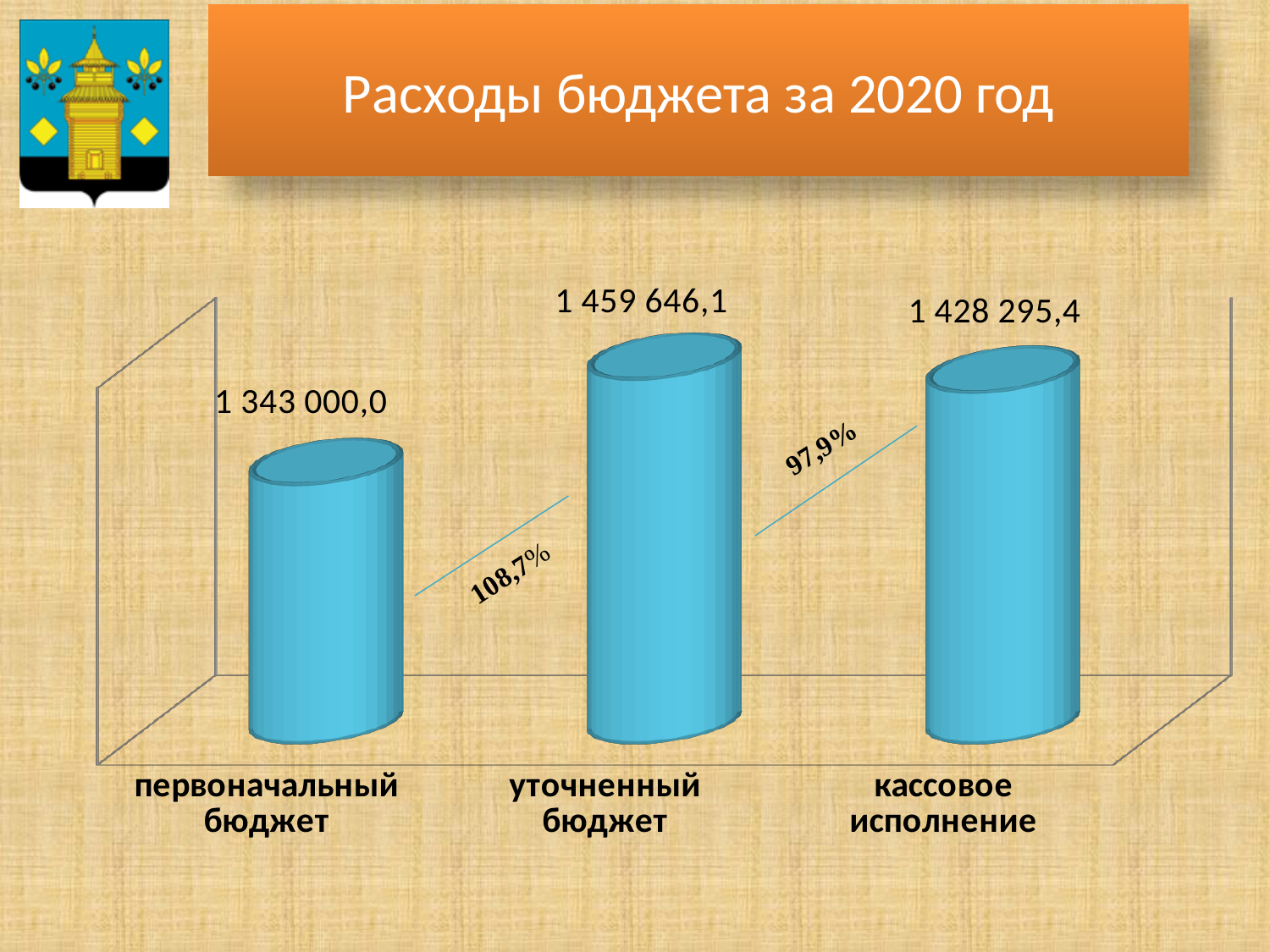
Which category has the highest value? уточненный бюджет What is the value for кассовое исполнение? 1 428 295,4 What kind of chart is shown on the slide? bar chart What is the difference between уточненный бюджет and первоначальный бюджет? 116 646,1 How many categories are shown in the chart? 3 What is the difference between уточненный бюджет and кассовое исполнение? 31 350,7 What is the value for первоначальный бюджет? 1 343 000,0 Which category has the lowest value? первоначальный бюджет What is the title of the slide? Расходы бюджета за 2020 год What is the value for уточненный бюджет? 1 459 646,1 What percentage is shown between уточненный бюджет and кассовое исполнение? 97,9% Which is larger, кассовое исполнение or первоначальный бюджет? кассовое исполнение